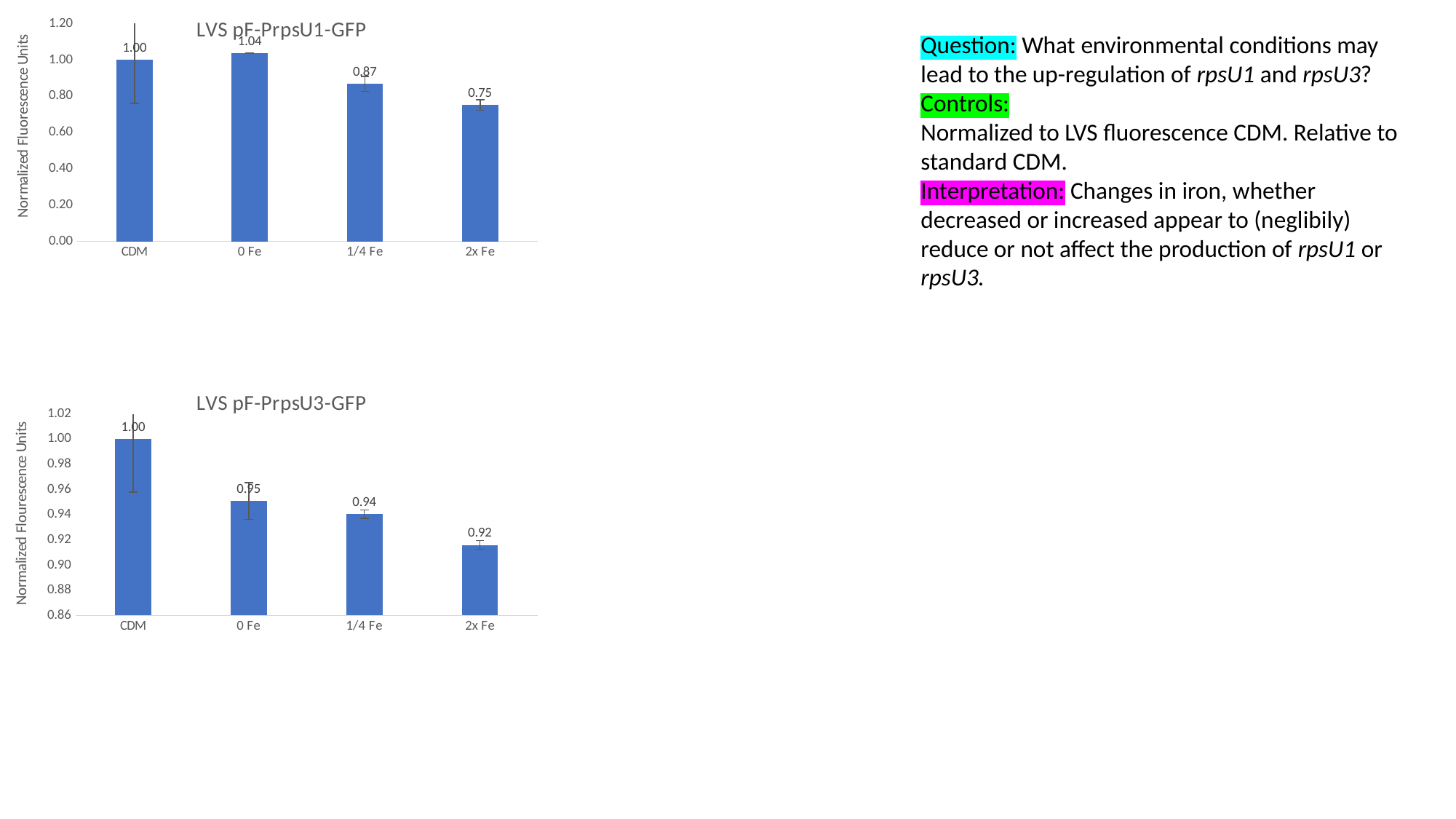
What kind of chart is the LVS pF-PrpsU1-GFP chart? bar chart In the LVS pF-PrpsU1-GFP chart, which category has the highest value? 0 Fe In the LVS pF-PrpsU3-GFP chart, which category has the lowest value? 2x Fe In the LVS pF-PrpsU1-GFP chart, which category has the lowest value? 2x Fe In the LVS pF-PrpsU1-GFP chart, what is the value for 2x Fe? 0.75 What is the y-axis label of the LVS pF-PrpsU3-GFP chart? Normalized Flourescence Units In the LVS pF-PrpsU3-GFP chart, what is the value for 1/4 Fe? 0.94 In the LVS pF-PrpsU1-GFP chart, what is the value for 0 Fe? 1.04 How many categories are shown on the x axis of the LVS pF-PrpsU3-GFP chart? 4 In the LVS pF-PrpsU1-GFP chart, what is the difference between the CDM value and the 1/4 Fe value? 0.13 In the LVS pF-PrpsU3-GFP chart, is the value for CDM larger or smaller than the value for 2x Fe? larger In the LVS pF-PrpsU3-GFP chart, what is the value for 0 Fe? 0.95